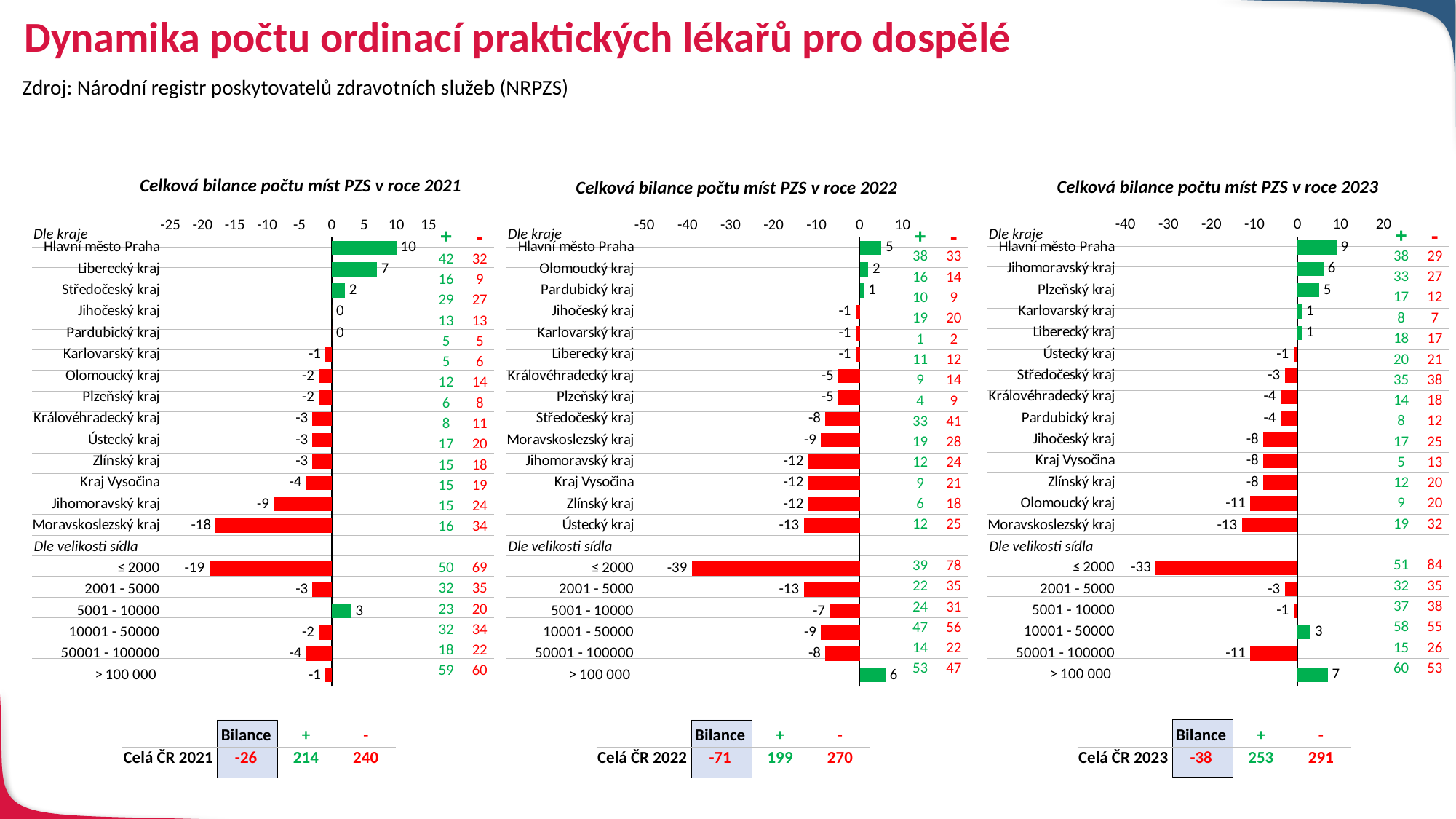
In the chart 'Celková bilance počtu míst PZS v roce 2021', what is the difference between the values for Liberecký kraj and Středočeský kraj? 5 What type of chart is 'Celková bilance počtu míst PZS v roce 2021'? Bar chart In the chart 'Celková bilance počtu míst PZS v roce 2023', what is the difference between the values for Hlavní město Praha and Jihomoravský kraj? 3 In the chart 'Celková bilance počtu míst PZS v roce 2022', which is larger: the value for Hlavní město Praha or the value for > 100 000? > 100 000 In the chart 'Celková bilance počtu míst PZS v roce 2022', what is the value for Ústecký kraj? -13 In the chart 'Celková bilance počtu míst PZS v roce 2022', which category has the lowest value? ≤ 2000 In the chart 'Celková bilance počtu míst PZS v roce 2021', what is the value for Moravskoslezský kraj? -18 In the chart 'Celková bilance počtu míst PZS v roce 2023', what is the value for > 100 000? 7 In the chart 'Celková bilance počtu míst PZS v roce 2021', what is the value for Hlavní město Praha? 10 In the chart 'Celková bilance počtu míst PZS v roce 2023', which category has the highest value? Hlavní město Praha In the chart 'Celková bilance počtu míst PZS v roce 2023', what is the value for Moravskoslezský kraj? -13 How many categories are plotted in the chart 'Celková bilance počtu míst PZS v roce 2022'? 20